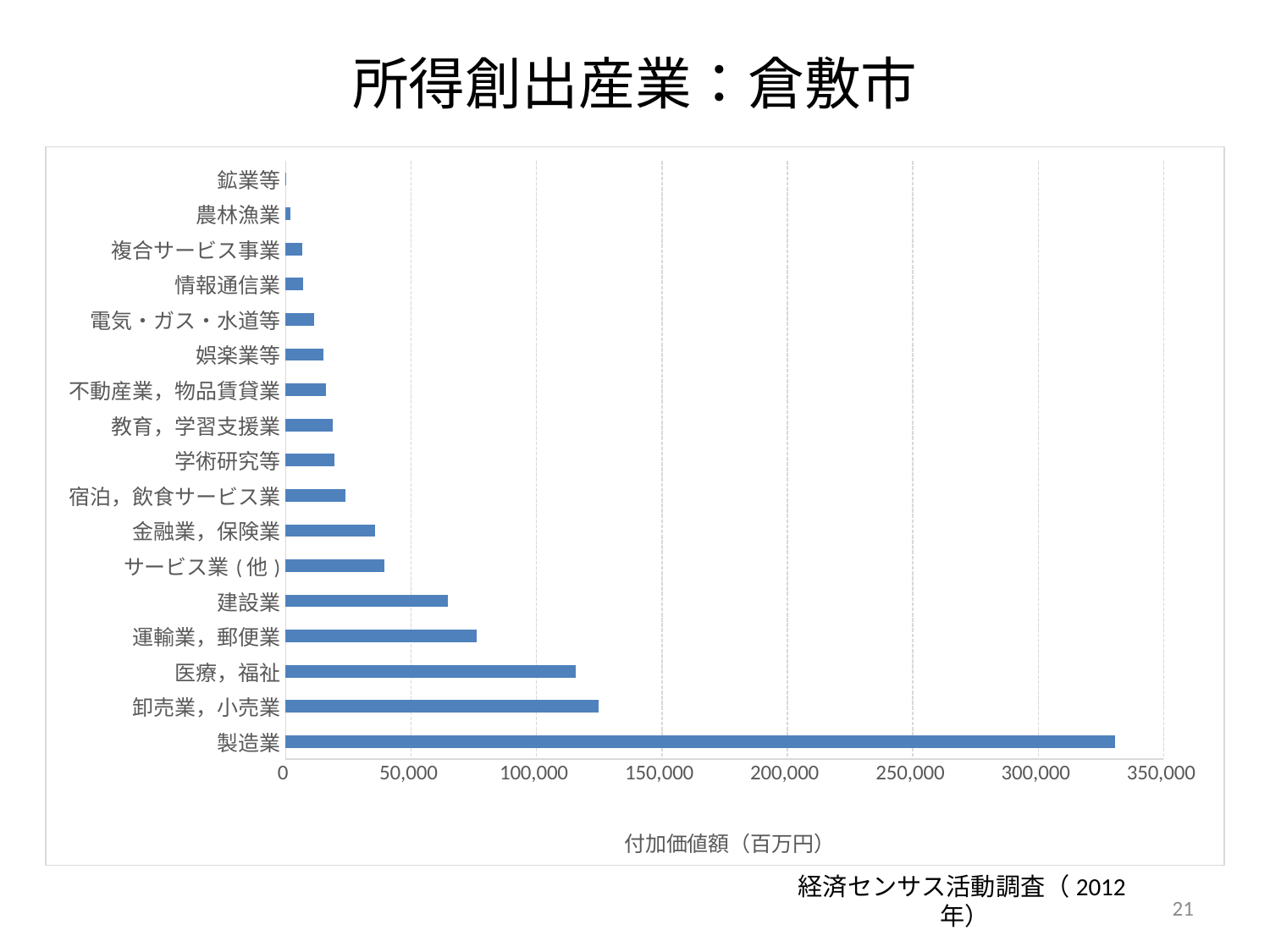
Is the value for 医療，福祉 greater or less than 150,000? less Is the value for 建設業 greater or less than 50,000? greater Which industry has the lowest value in the chart? 鉱業等 Which is larger, the value for 運輸業，郵便業 or the value for 建設業? 運輸業，郵便業 What is the label of the horizontal axis of the chart? 付加価値額（百万円） Is the value for 卸売業，小売業 greater or less than 100,000? greater What kind of chart is shown on the slide? bar chart Which is larger, the value for 医療，福祉 or the value for 運輸業，郵便業? 医療，福祉 How many industry categories are plotted in the chart? 17 Which industry has the highest value in the chart? 製造業